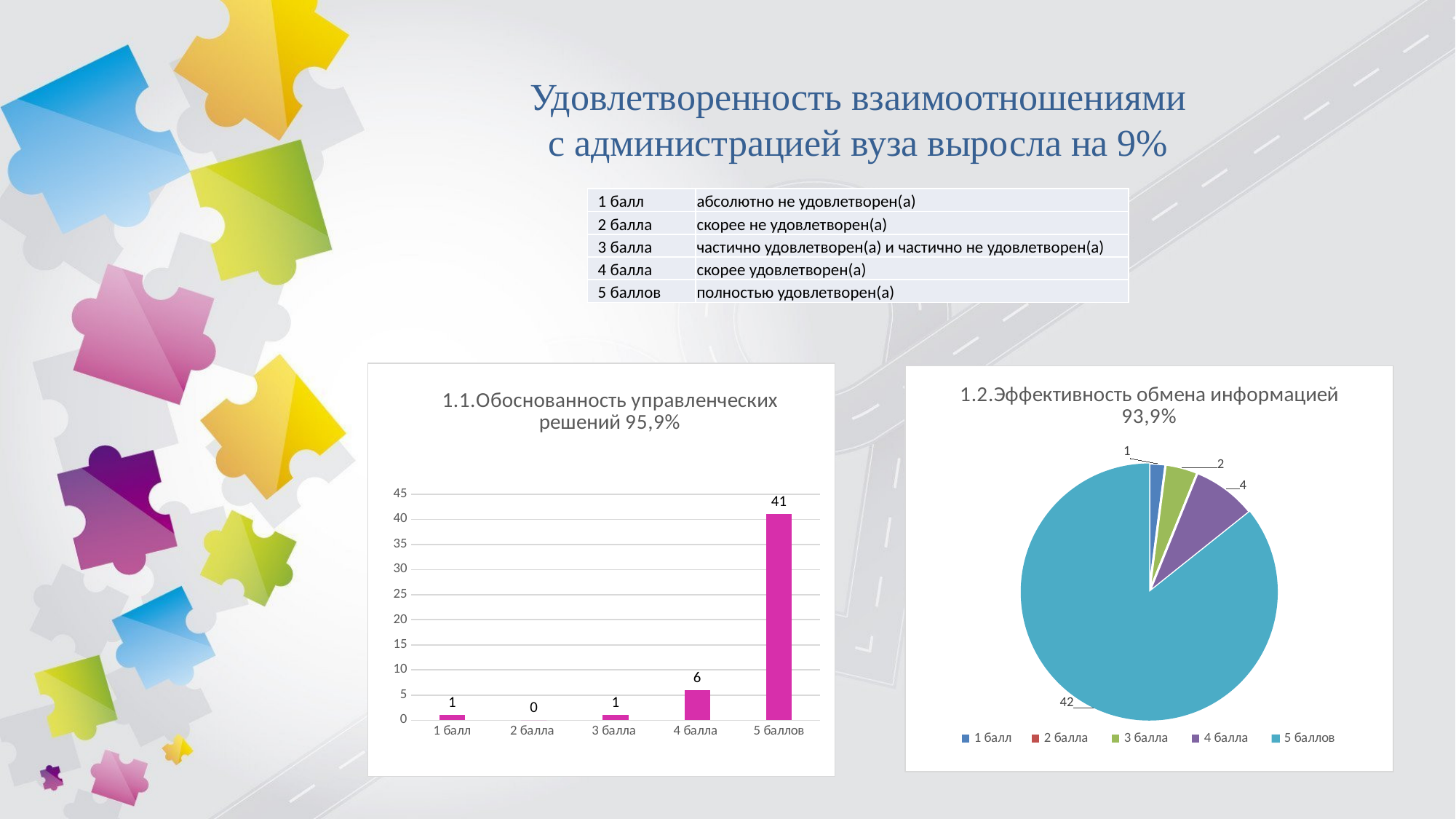
In the pie chart '1.2.Эффективность обмена информацией 93,9%', what is the value labelled for the 4 балла slice? 4 In the bar chart '1.1.Обоснованность управленческих решений 95,9%', what is the value for 5 баллов? 41 In the bar chart '1.1.Обоснованность управленческих решений 95,9%', what is the value for 2 балла? 0 In the bar chart '1.1.Обоснованность управленческих решений 95,9%', which category has the highest value? 5 баллов In the pie chart '1.2.Эффективность обмена информацией 93,9%', how many entries does the legend list? 5 In the bar chart '1.1.Обоснованность управленческих решений 95,9%', what is the difference between the values for 5 баллов and 4 балла? 35 In the bar chart '1.1.Обоснованность управленческих решений 95,9%', what is the value for 4 балла? 6 In the pie chart '1.2.Эффективность обмена информацией 93,9%', what is the value labelled for the 5 баллов slice? 42 What kind of chart is the chart titled '1.2.Эффективность обмена информацией 93,9%'? pie chart In the bar chart '1.1.Обоснованность управленческих решений 95,9%', how many categories are shown on the x axis? 5 What kind of chart is the chart titled '1.1.Обоснованность управленческих решений 95,9%'? bar chart In the bar chart '1.1.Обоснованность управленческих решений 95,9%', which category has the lowest value? 2 балла